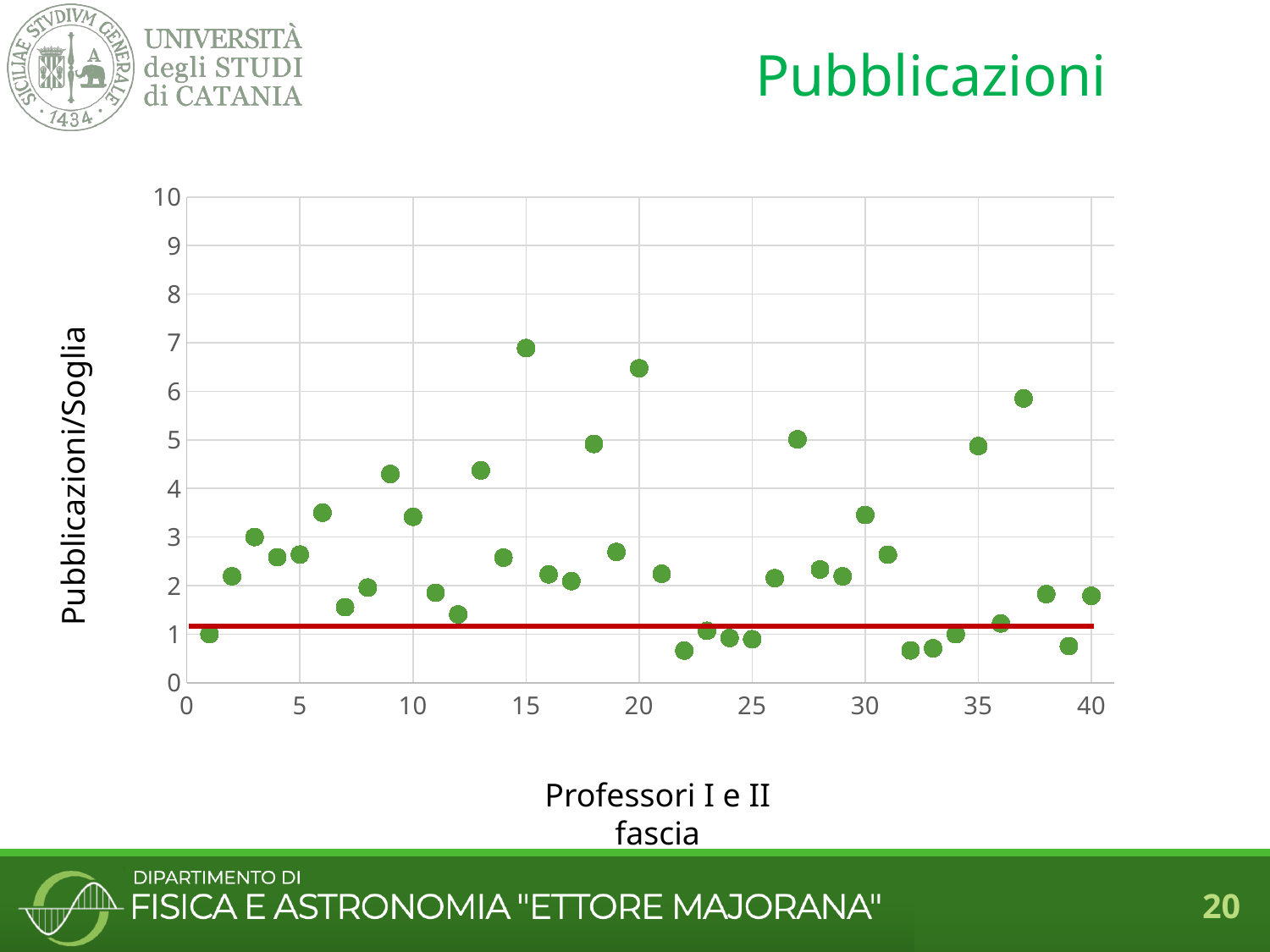
Is the value for the point at x = 9 greater or less than 4? greater What is the title of the slide's chart? Pubblicazioni What kind of chart is shown on the slide? scatter chart How many data points are plotted in the chart? 40 Which point is higher, the one at x = 3 or the one at x = 4? x = 3 What is the label of the vertical axis? Pubblicazioni/Soglia Which x value has the highest Pubblicazioni/Soglia point? 15 Is the value for the point at x = 15 greater or less than 6? greater Is the value for the point at x = 32 greater or less than 1? less Which point is higher, the one at x = 15 or the one at x = 20? x = 15